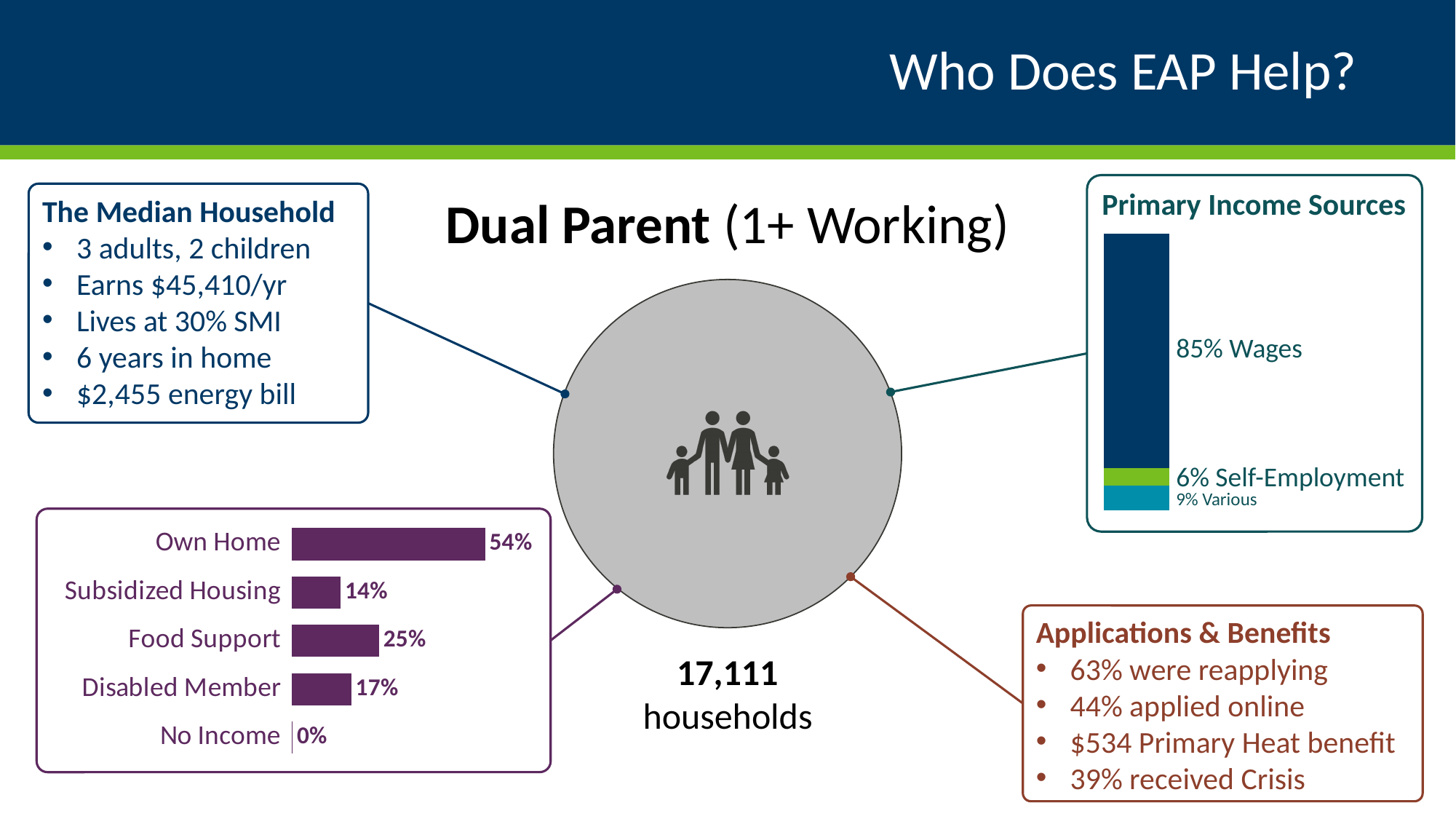
In the Primary Income Sources chart, what share is Wages? 85% In the Primary Income Sources chart, which segment is the largest? Wages In the bar chart at the bottom left of the slide, which is larger, Food Support or Disabled Member? Food Support In the bar chart at the bottom left of the slide, what is the value for Disabled Member? 17% In the bar chart at the bottom left of the slide, what is the value for Own Home? 54% What kind of chart is shown at the bottom left of the slide? Bar chart In the bar chart at the bottom left of the slide, which category has the lowest value? No Income In the bar chart at the bottom left of the slide, which category has the highest value? Own Home In the bar chart at the bottom left of the slide, what is the difference between Own Home and Subsidized Housing? 40% In the Primary Income Sources chart, what share is Self-Employment? 6% How many categories does the bar chart at the bottom left of the slide show? 5 In the bar chart at the bottom left of the slide, what is the value for Food Support? 25%